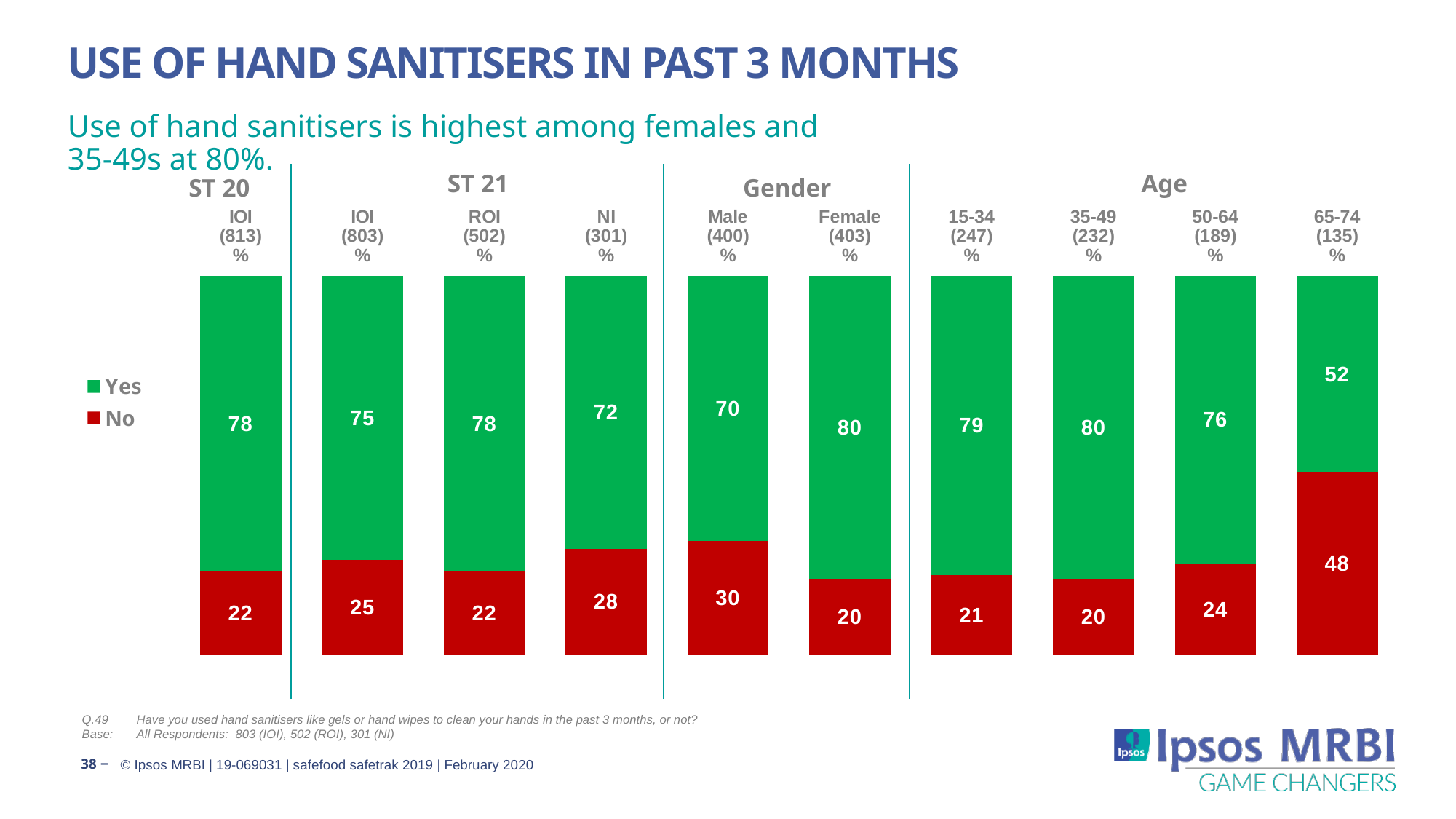
What is the difference between the 'Yes' values for Female and Male? 10 What is the difference between the 'No' values for NI and ROI in ST 21? 6 Which colour represents 'No' in the chart? Red What type of chart is shown on the slide? Stacked bar chart Which gender category has the higher 'No' value? Male What is the 'No' value for the 65-74 age group? 48 How many bars are shown in the chart? 10 What is the total of the stacked bar for the 35-49 age group? 100 What is the 'Yes' value for NI in ST 21? 72 Which category has the lowest 'Yes' value? 65-74 What is the 'Yes' value for Female? 80 How many series does the legend list? 2